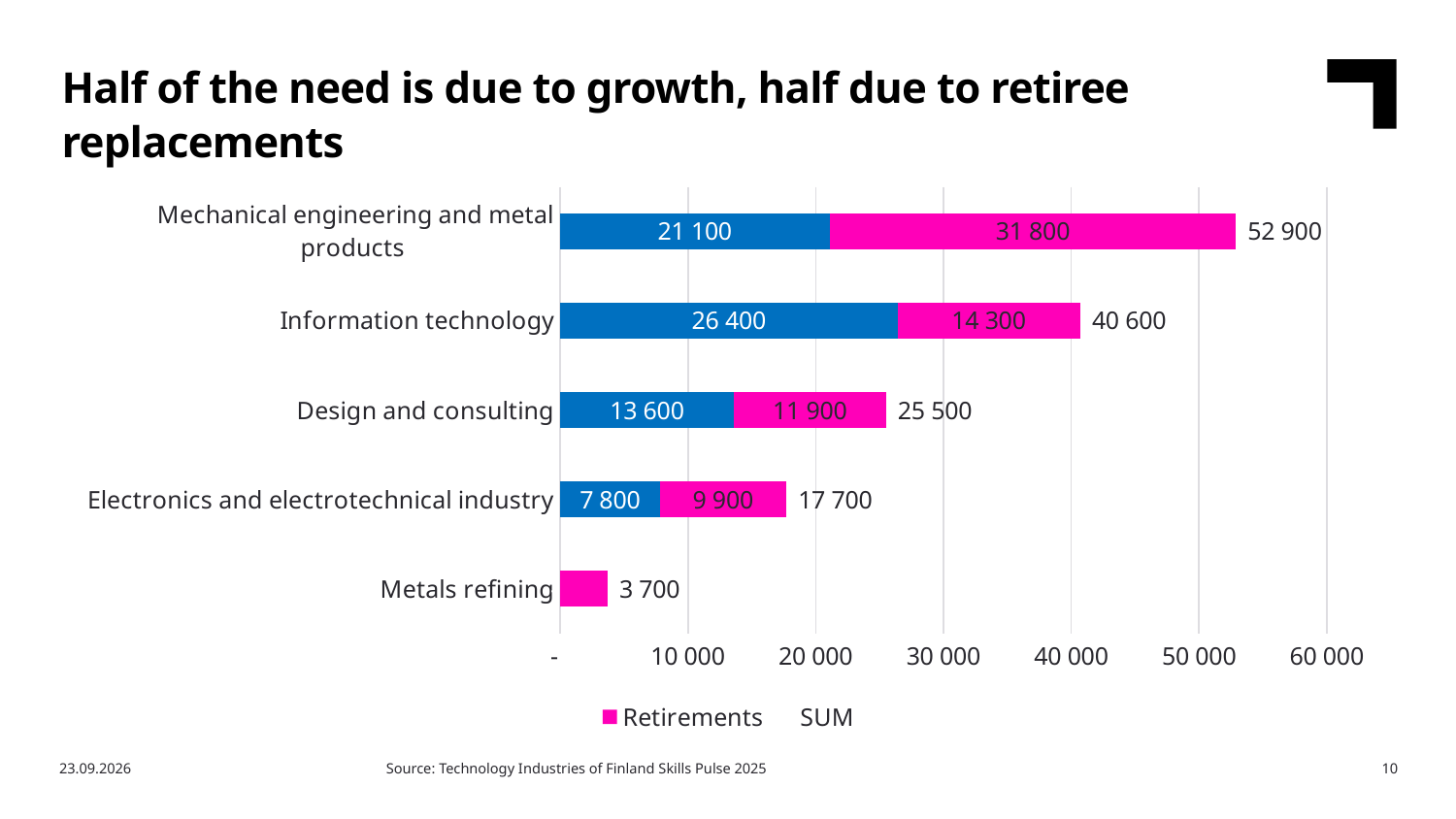
Which category has the lowest total (SUM) value? Metals refining What is the total of the stacked bar for Electronics and electrotechnical industry? 17 700 What is the difference between the SUM values for Mechanical engineering and metal products and Information technology? 12 300 Which category has the highest total (SUM) value? Mechanical engineering and metal products What kind of chart is shown on the slide? Stacked bar chart What is the SUM value shown for Design and consulting? 25 500 What is the difference between the Retirements values for Design and consulting and Electronics and electrotechnical industry? 2 000 Which has the larger Retirements value, Mechanical engineering and metal products or Information technology? Mechanical engineering and metal products What is the Retirements value for Metals refining? 3 700 Is the total value for Electronics and electrotechnical industry greater or less than 20 000? less How many categories are shown on the chart? 5 What is the Retirements value for Information technology? 14 300